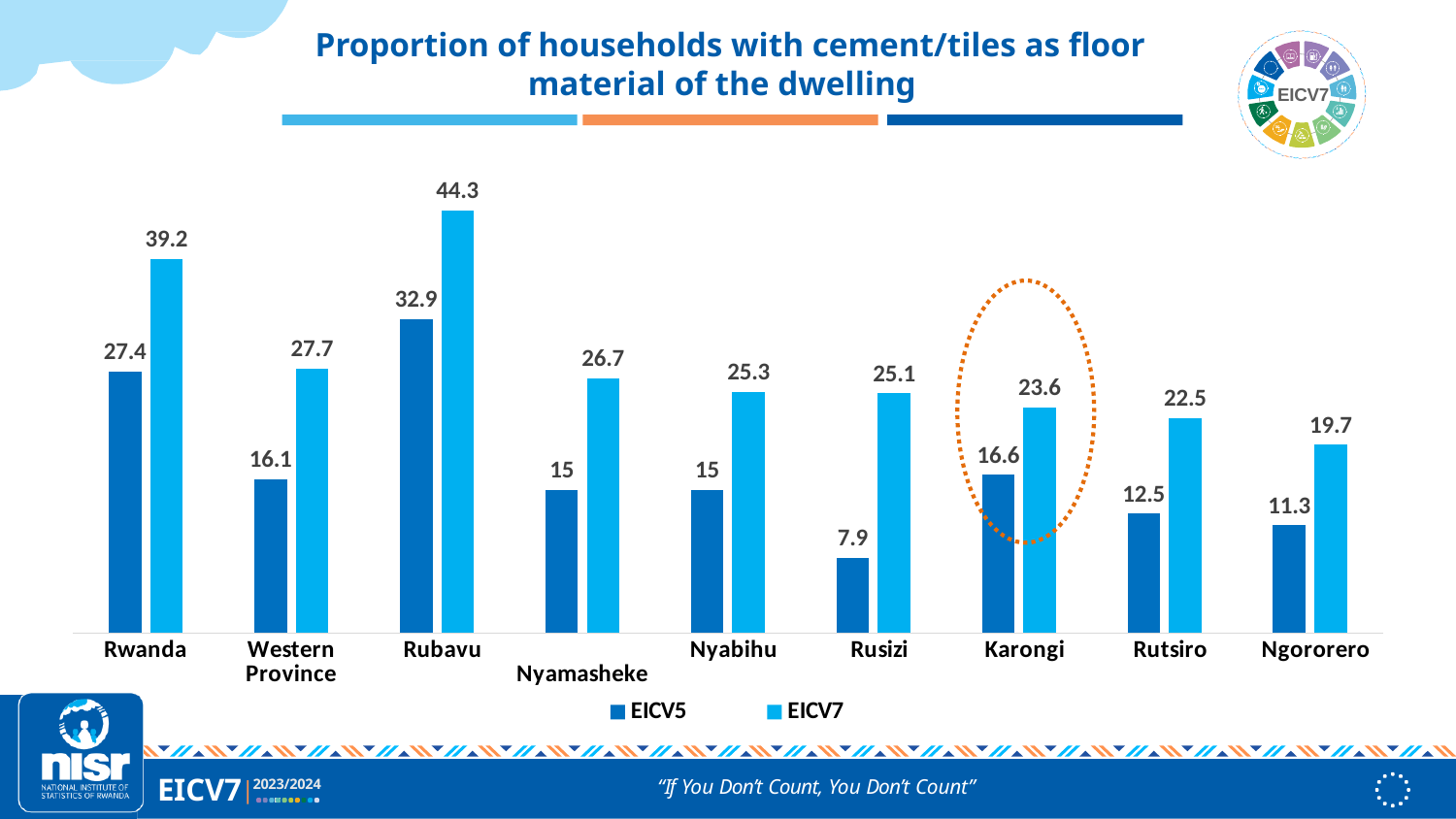
Which category has the highest EICV7 value? Rubavu Which category has the lowest EICV5 value? Rusizi What is the EICV5 value for Western Province? 16.1 What kind of chart is shown on the slide? Bar chart Which is larger: the EICV7 value for Rutsiro or the EICV7 value for Ngororero? Rutsiro How many categories are shown on the x axis? 9 What is the difference between the EICV7 and EICV5 values for Rwanda? 11.8 Which category is highlighted with a dotted orange circle? Karongi What is the EICV5 value for Rusizi? 7.9 What is the EICV7 value for Rubavu? 44.3 What is the EICV7 value for Karongi? 23.6 How many series does the legend list? 2